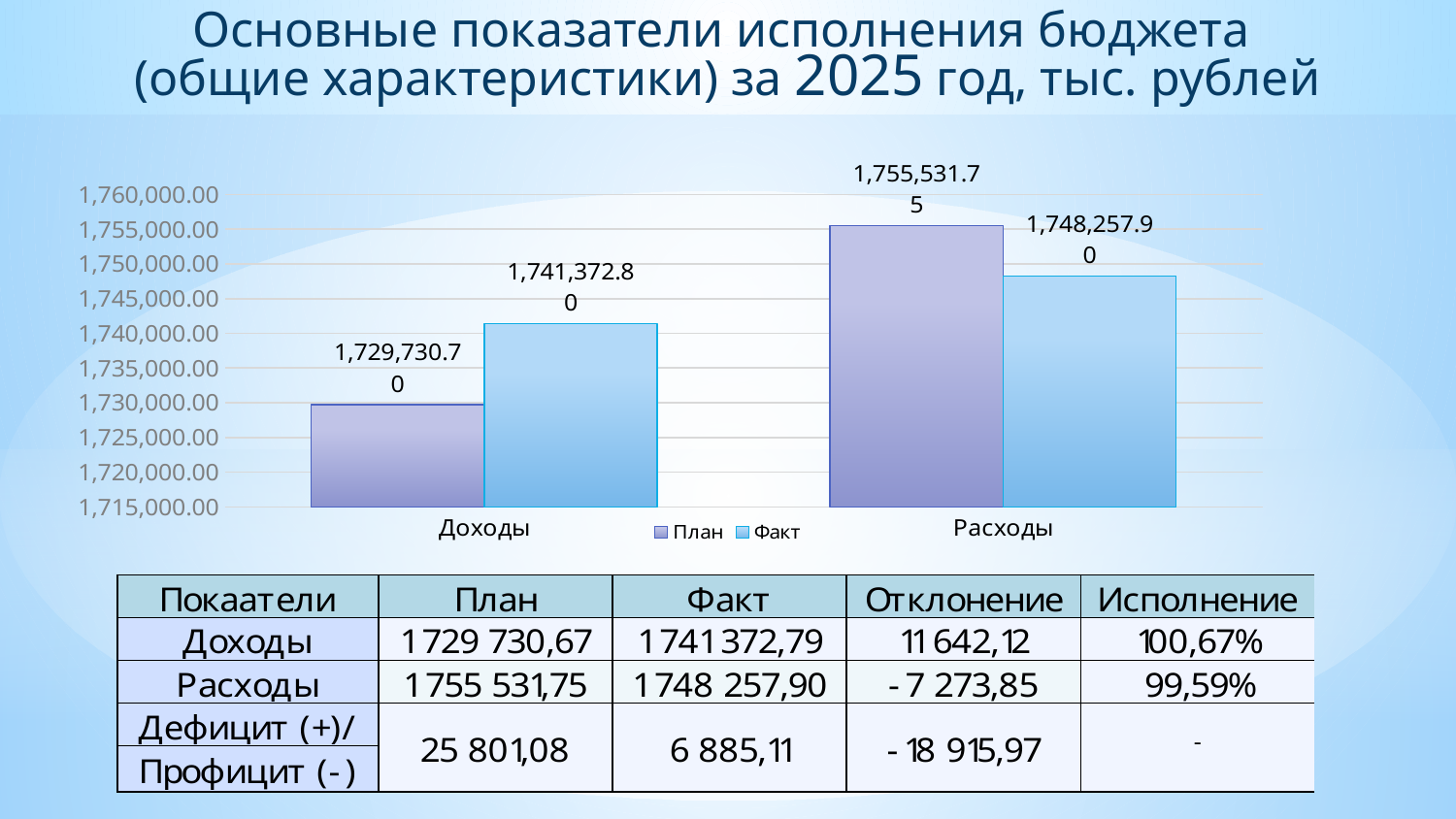
What is the Факт value for Доходы in the chart? 1,741,372.80 What is the План value for Доходы in the chart? 1,729,730.70 For Расходы, which is larger in the chart: План or Факт? План Is the Факт value for Доходы greater or less than 1,740,000.00? greater How many categories are shown on the x axis of the chart? 2 What is the Факт value for Расходы in the chart? 1,748,257.90 For Доходы, which is larger in the chart: План or Факт? Факт What is the План value for Расходы in the chart? 1,755,531.75 Which bar in the chart has the lowest value? План for Доходы What type of chart is shown on the slide? Bar chart How many series does the chart legend list? 2 Which bar in the chart has the highest value? План for Расходы